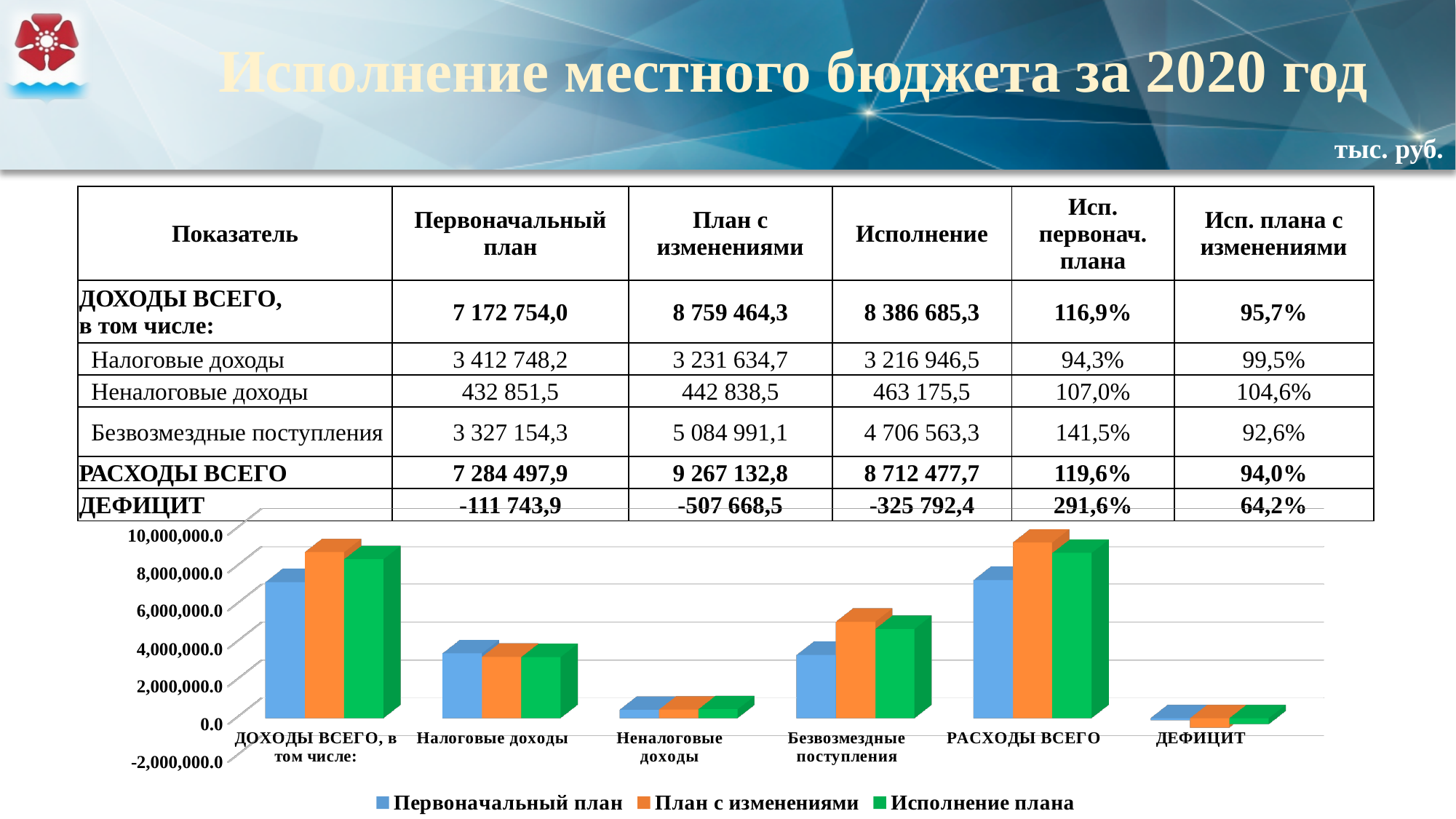
Is the 'Исполнение плана' value for Неналоговые доходы greater or less than 2,000,000.0? less For Безвозмездные поступления, which is larger: 'Первоначальный план' or 'План с изменениями'? План с изменениями According to the slide, what is the 'Исполнение' value for РАСХОДЫ ВСЕГО? 8 712 477,7 What colour represents 'Исполнение плана' in the chart's legend? green Is the 'Первоначальный план' value for Налоговые доходы greater or less than 4,000,000.0? less How many categories are shown along the x axis of the chart? 6 What kind of chart is shown below the table on the slide? bar chart How many series does the chart's legend list? 3 Which category has the lowest 'Первоначальный план' bar in the chart? ДЕФИЦИТ Which category has the tallest 'План с изменениями' bar in the chart? РАСХОДЫ ВСЕГО Is the 'План с изменениями' value for Безвозмездные поступления greater or less than 4,000,000.0? greater According to the slide, what is the difference between 'План с изменениями' and 'Исполнение' for ДОХОДЫ ВСЕГО? 372 779,0